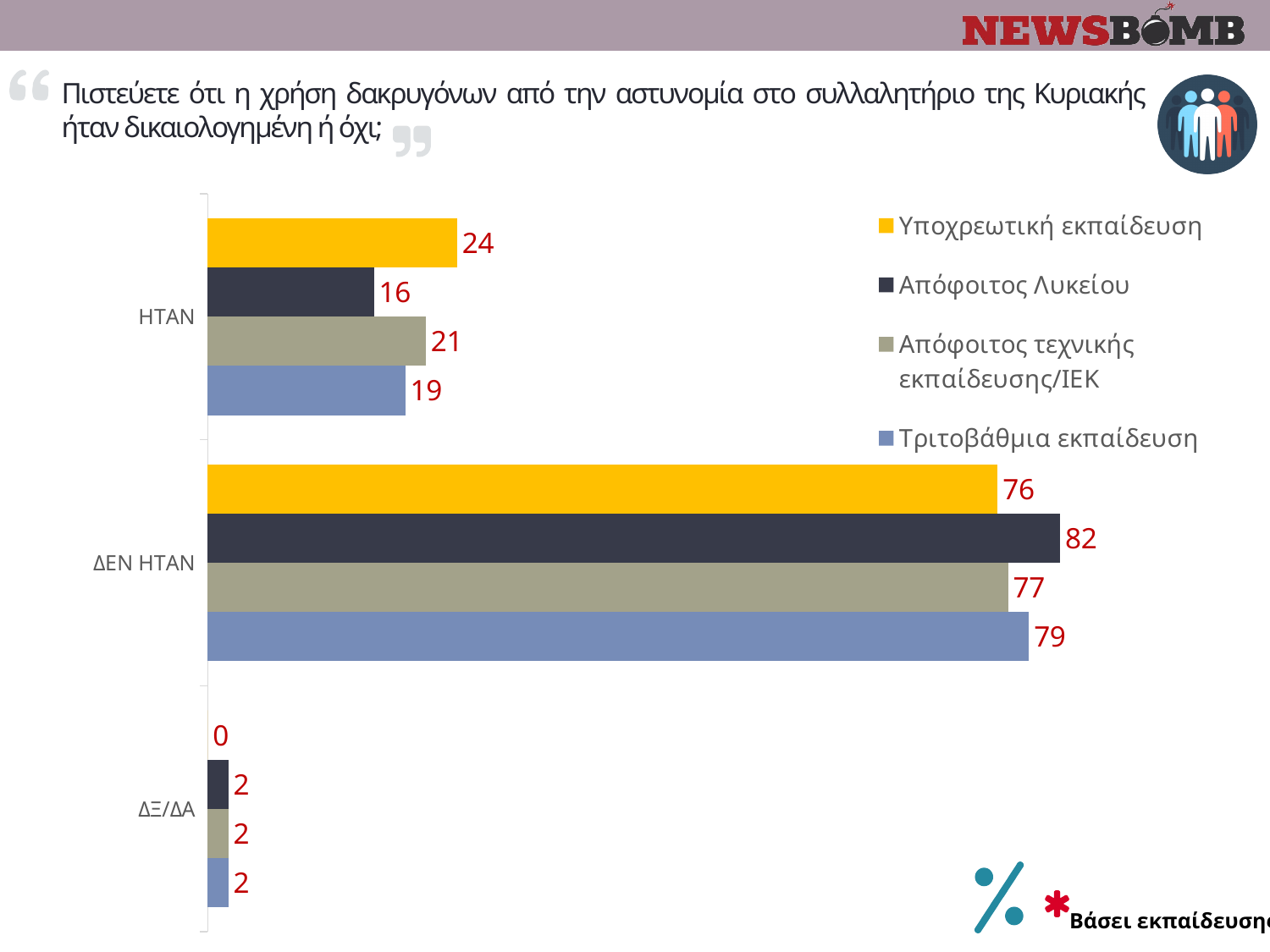
Which is larger in the ΗΤΑΝ category: Απόφοιτος τεχνικής εκπαίδευσης/ΙΕΚ or Τριτοβάθμια εκπαίδευση? Απόφοιτος τεχνικής εκπαίδευσης/ΙΕΚ What is the value for Απόφοιτος Λυκείου in the ΔΕΝ ΗΤΑΝ category? 82 Which series has the lowest value in the ΗΤΑΝ category? Απόφοιτος Λυκείου Which series has the highest value in the ΔΕΝ ΗΤΑΝ category? Απόφοιτος Λυκείου How many series does the legend list? 4 What is the value for Τριτοβάθμια εκπαίδευση in the ΗΤΑΝ category? 19 What kind of chart is shown on the slide? Bar chart What is the difference between the Απόφοιτος Λυκείου values for ΔΕΝ ΗΤΑΝ and ΗΤΑΝ? 66 What is the value for Υποχρεωτική εκπαίδευση in the ΗΤΑΝ category? 24 What is the value for Υποχρεωτική εκπαίδευση in the ΔΞ/ΔΑ category? 0 How many categories are shown on the chart? 3 What colour represents Υποχρεωτική εκπαίδευση in the legend? Yellow